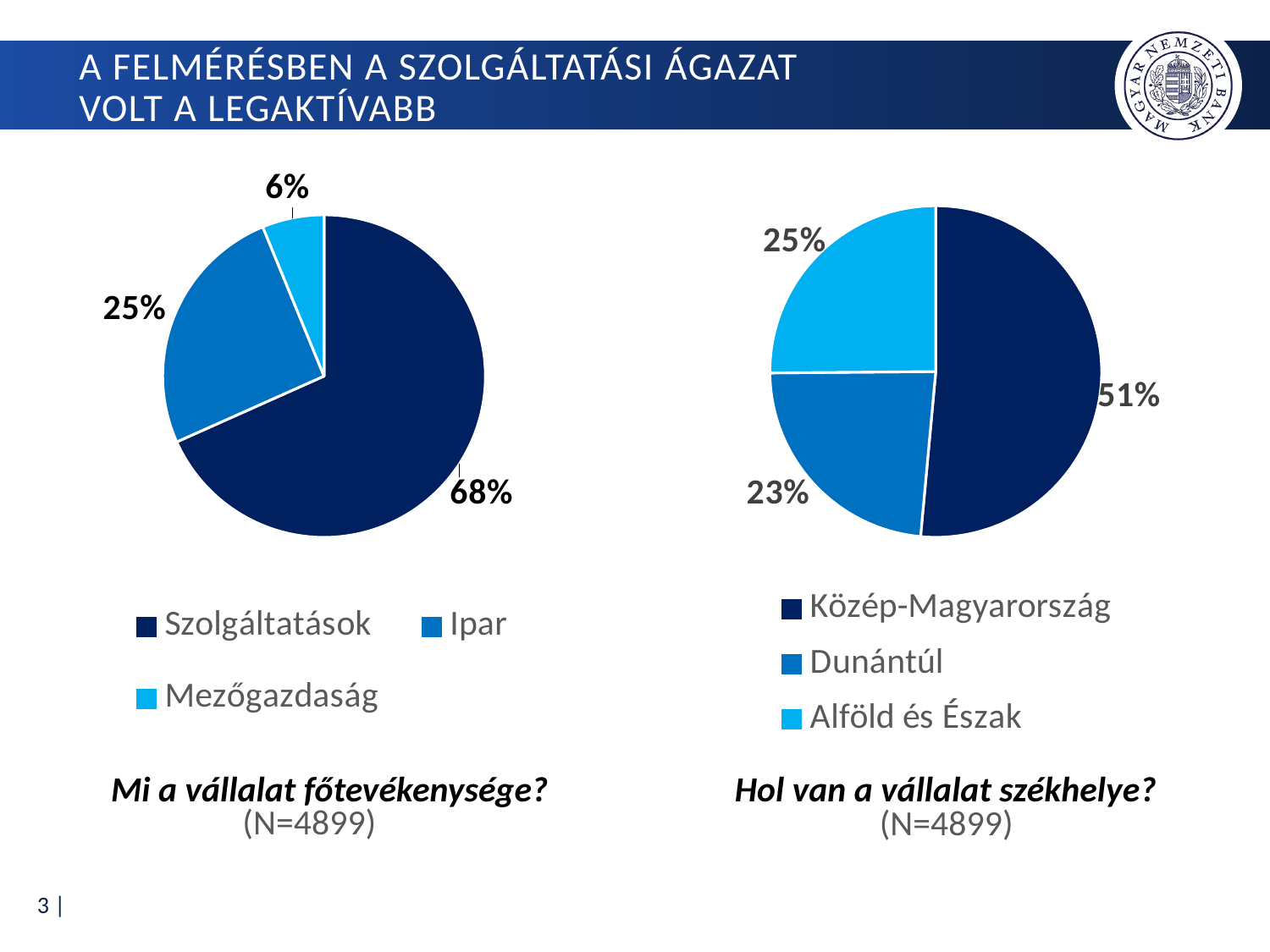
What type of chart is used on the left side of the slide? Pie chart In the right pie chart (Hol van a vállalat székhelye?), which is larger: Alföld és Észak or Dunántúl? Alföld és Észak In the left pie chart (Mi a vállalat főtevékenysége?), which category has the largest share? Szolgáltatások What sample size (N) is shown under the right pie chart (Hol van a vállalat székhelye?)? N=4899 In the left pie chart (Mi a vállalat főtevékenysége?), what share is Mezőgazdaság? 6% In the right pie chart (Hol van a vállalat székhelye?), which region has the smallest share? Dunántúl In the left pie chart (Mi a vállalat főtevékenysége?), what is the difference between the shares of Szolgáltatások and Ipar? 43 percentage points In the left pie chart (Mi a vállalat főtevékenysége?), which category has the smallest share? Mezőgazdaság In the right pie chart (Hol van a vállalat székhelye?), what share is Dunántúl? 23% How many slices does the right pie chart (Hol van a vállalat székhelye?) have? 3 In the left pie chart (Mi a vállalat főtevékenysége?), what share is Szolgáltatások? 68% In the right pie chart (Hol van a vállalat székhelye?), what share is Közép-Magyarország? 51%